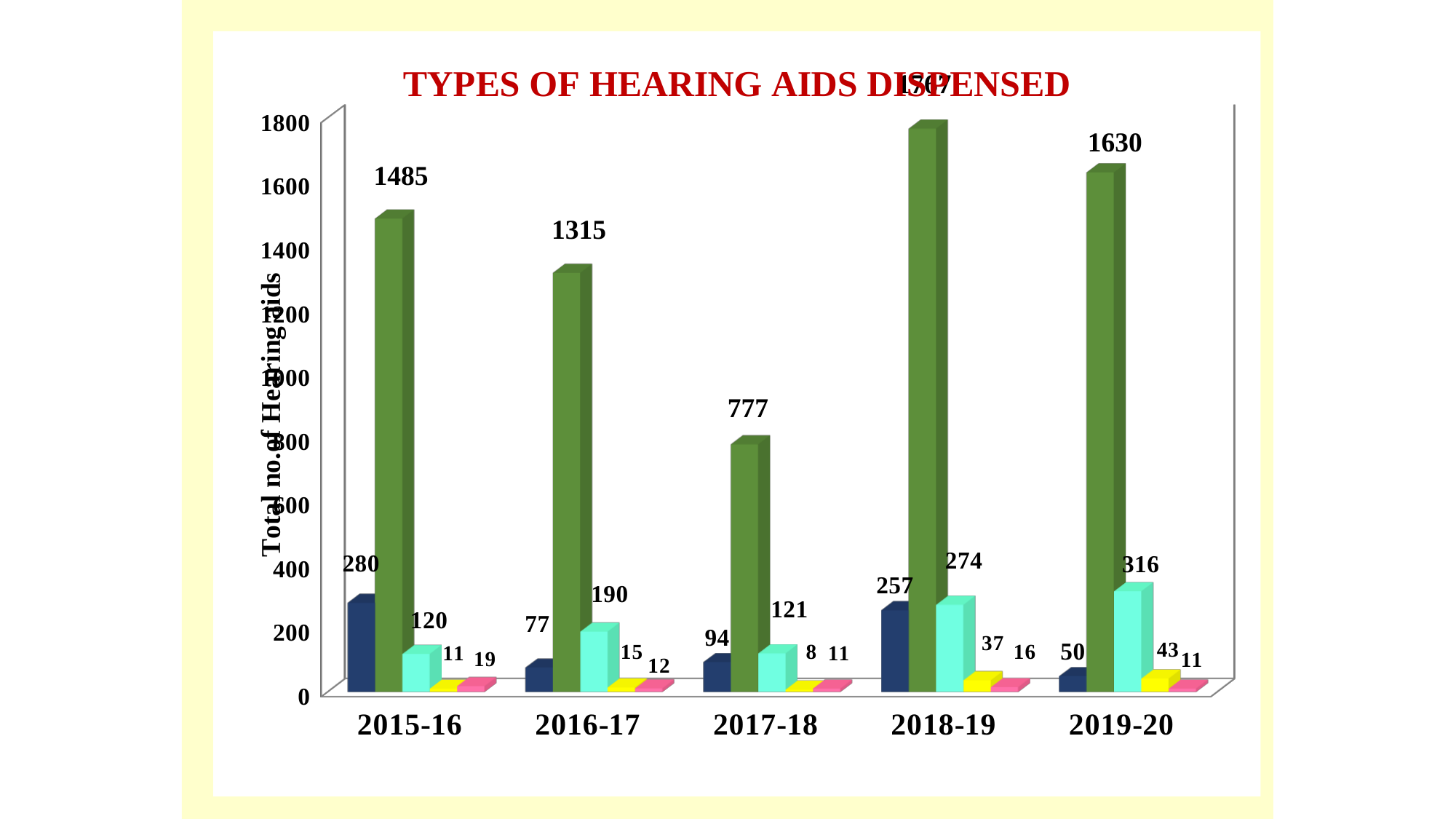
Which year has the highest value for the light cyan bar? 2019-20 How many year categories are shown on the x axis? 5 What type of chart is shown on the slide? bar chart What is the difference between the green bar values for 2015-16 and 2016-17? 170 Which is larger: the dark blue bar for 2018-19 or the dark blue bar for 2019-20? 2018-19 What is the value of the light cyan bar for 2018-19? 274 What is the value of the yellow bar for 2017-18? 8 What is the value of the green bar for 2019-20? 1630 What is the value of the pink bar for 2016-17? 12 Among the green bars with readable labels, which year has the lowest value? 2017-18 What is the value of the dark blue bar for 2015-16? 280 What is the title of the chart? TYPES OF HEARING AIDS DISPENSED